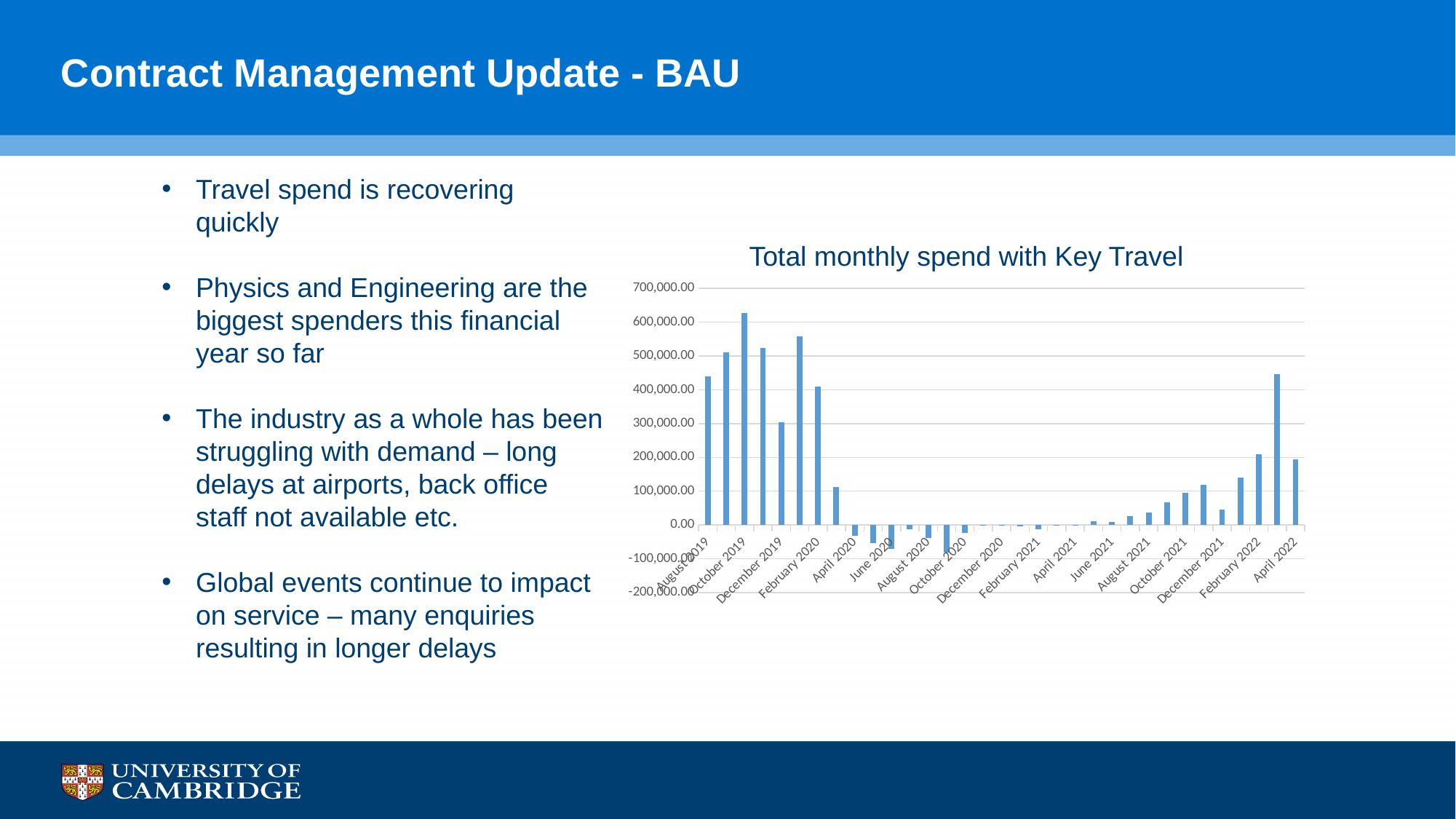
Which is larger, the spend in December 2019 or the spend in April 2022? December 2019 What kind of chart is shown on the slide? Bar chart Is the value for October 2019 greater or less than 600,000.00? greater Which month has the highest total monthly spend with Key Travel? October 2019 Is the value for August 2019 greater or less than 400,000.00? greater Is the value for February 2022 greater or less than 100,000.00? greater Which is larger, the spend in October 2019 or the spend in April 2022? October 2019 What is the title of the chart? Total monthly spend with Key Travel Do the values generally rise or fall from June 2021 to February 2022? rise What is the highest value shown on the vertical axis? 700,000.00